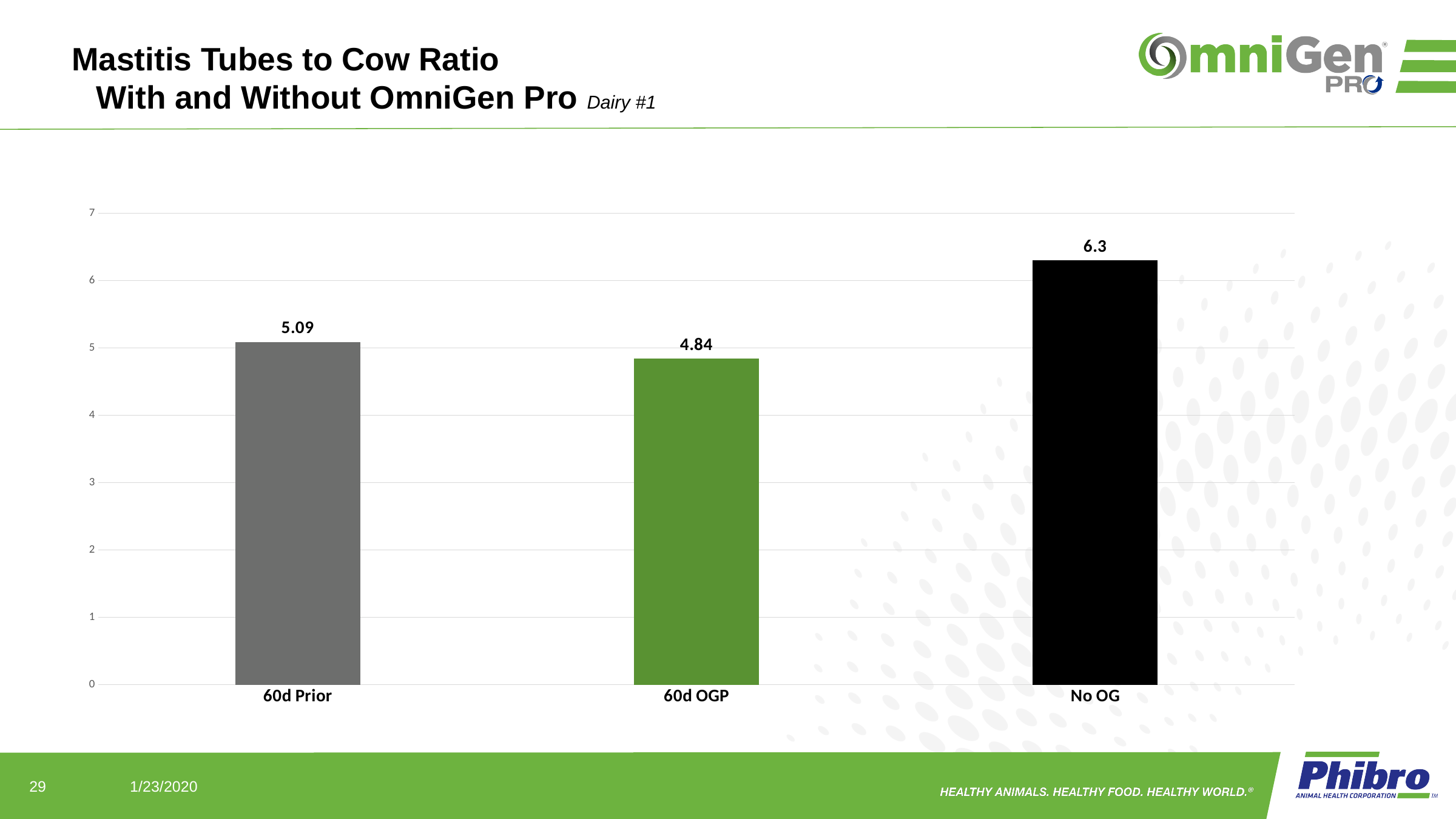
What is the value for No OG? 6.3 What is the value for 60d OGP? 4.84 What is the difference between the values for No OG and 60d OGP? 1.46 Which is larger, the value for 60d Prior or the value for No OG? No OG What colour is the bar for 60d OGP? green Which category has the lowest value? 60d OGP What is the difference between the values for 60d Prior and 60d OGP? 0.25 Is the value for No OG greater or less than 6? greater What is the value for 60d Prior? 5.09 What kind of chart is shown on the slide? bar chart Which category has the highest value? No OG How many categories are shown on the x axis? 3